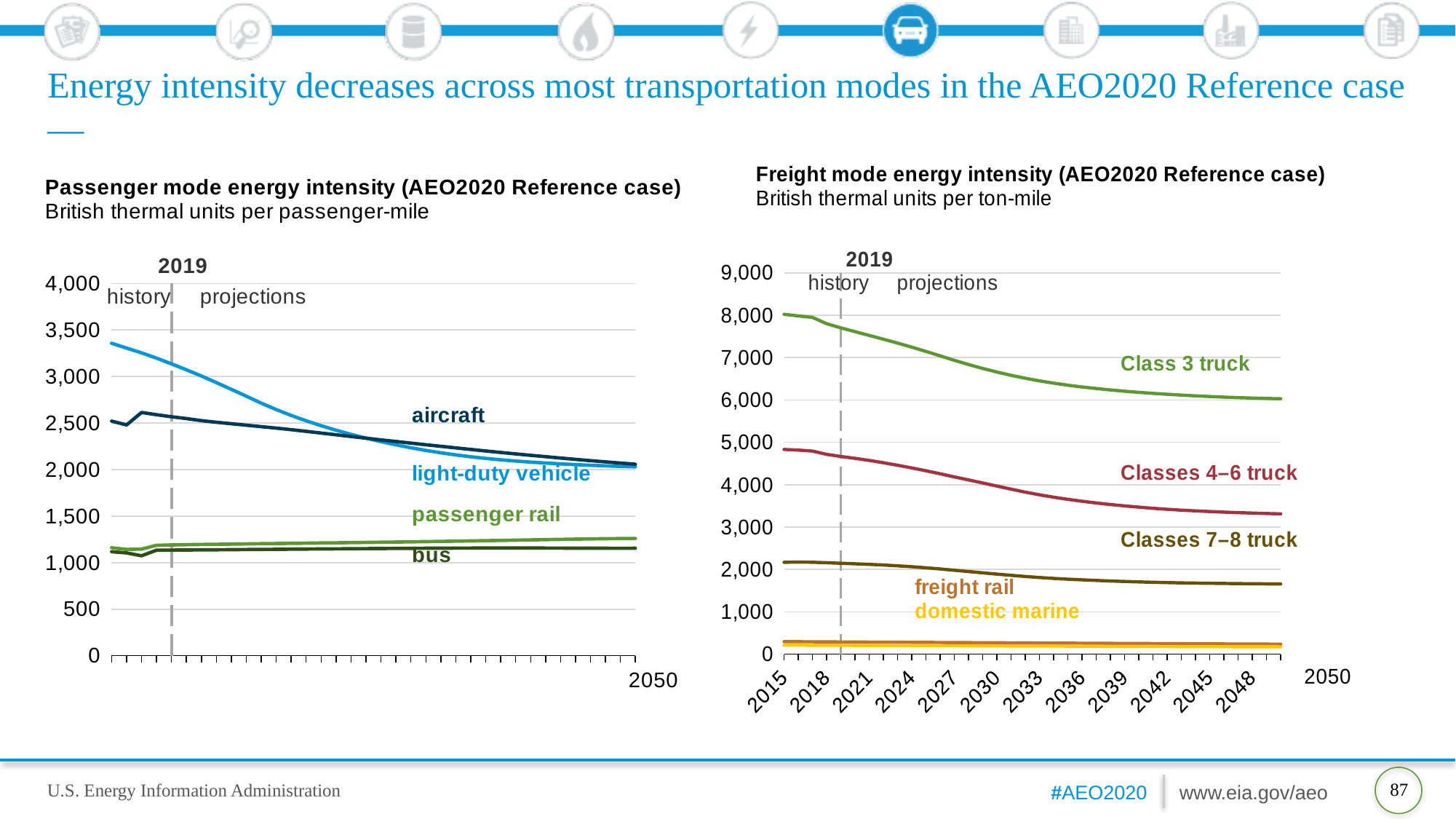
On the Passenger mode energy intensity chart, does the light-duty vehicle line rise or fall from 2015 to 2050? fall What unit is used on the Freight mode energy intensity chart? British thermal units per ton-mile On the Freight mode energy intensity chart, is the value for Class 3 truck in 2015 greater or less than 7,000? greater What kind of chart is the Passenger mode energy intensity chart? line chart On the Freight mode energy intensity chart, which series has the highest energy intensity throughout the period? Class 3 truck On the Freight mode energy intensity chart, is the value for Classes 4–6 truck in 2050 greater or less than 3,000? greater How many series are plotted on the Freight mode energy intensity chart? 5 On the Freight mode energy intensity chart, which is larger in 2050: Class 3 truck or Classes 4–6 truck? Class 3 truck On the Freight mode energy intensity chart, does the Class 3 truck line rise or fall over the projection period? fall On the Passenger mode energy intensity chart, is the value for light-duty vehicle in 2015 greater or less than 3,000? greater How many series are plotted on the Passenger mode energy intensity chart? 4